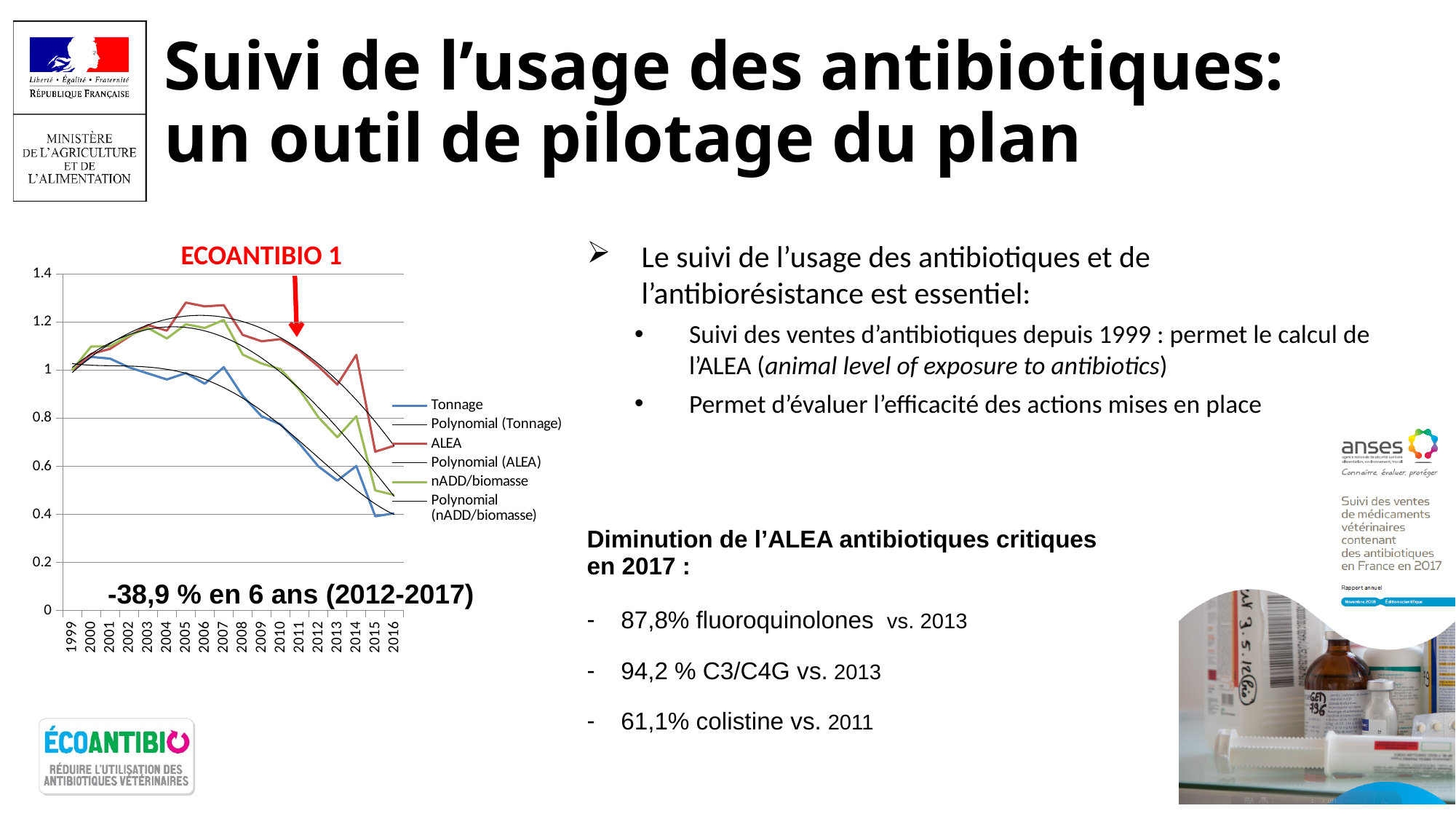
Is the ALEA value for 2006 greater or less than 1.2? greater What is the first year shown on the x axis of the chart? 1999 How many entries does the legend of the chart list? 6 What kind of chart is shown on the left of the slide? line chart Is the Tonnage value for 2016 greater or less than 0.6? less What colour is the ALEA line in the chart? red How many years are plotted along the x axis of the chart? 18 Is the nADD/biomasse value for 2016 greater or less than 0.6? less In 2014, which is larger: the ALEA value or the Tonnage value? ALEA Does the Tonnage series rise or fall overall from 1999 to 2016? fall Which year does the red 'ECOANTIBIO 1' arrow point to on the chart? 2011